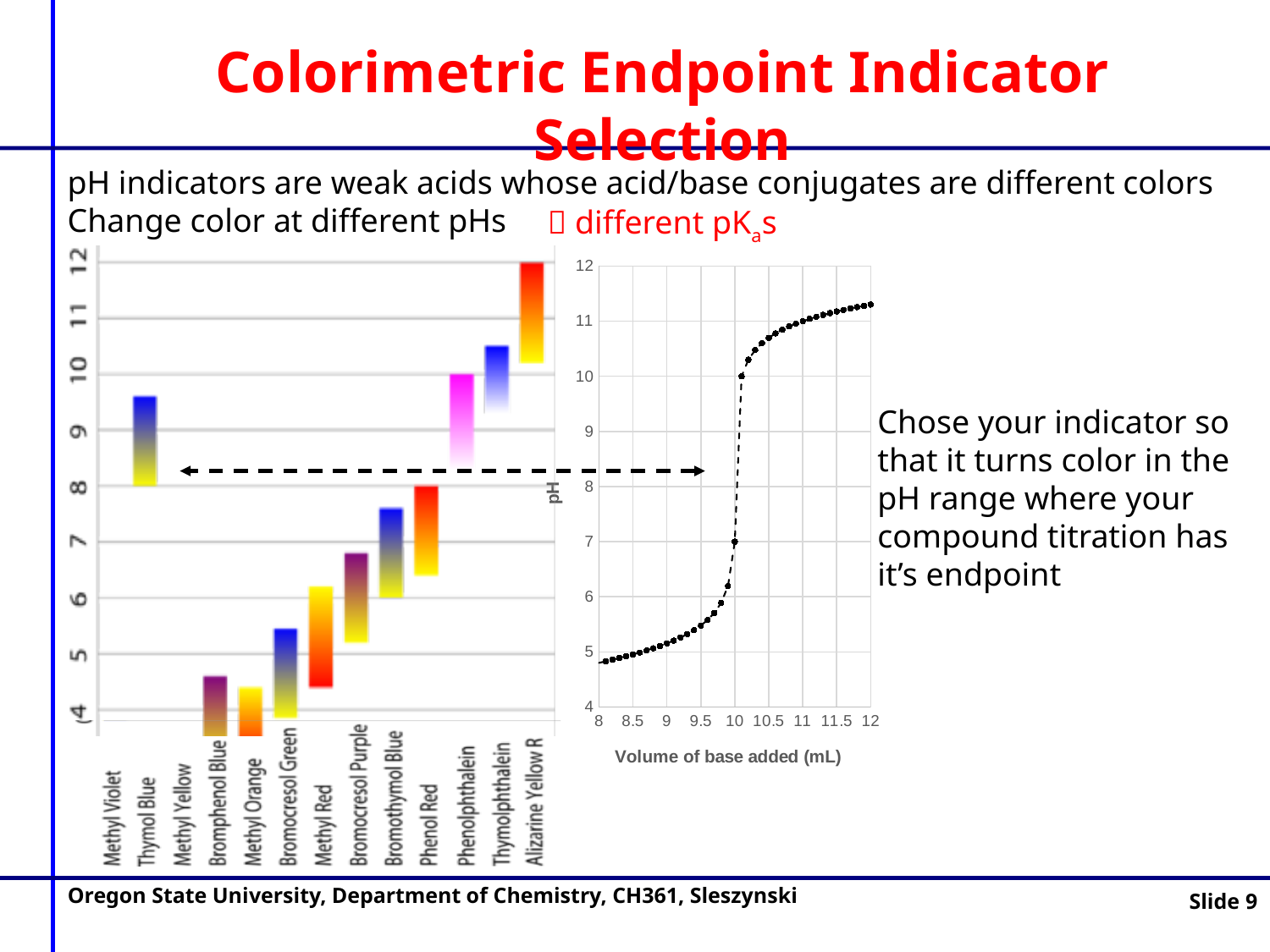
What kind of chart is the chart on the left showing indicator pH ranges? bar chart How many indicators are listed along the x axis of the chart on the left? 13 In the chart on the left, is the upper end of Phenolphthalein's range greater or less than 9? greater In the chart on the left, is the upper end of Thymol Blue's range greater or less than 9? greater In the chart on the right, does pH rise or fall as the volume of base added increases? rises In the chart on the right, is the pH at 12 mL of base added greater or less than 11? greater What is the x-axis label of the chart on the right? Volume of base added (mL) What kind of chart is the chart on the right of the slide (pH versus volume of base added)? line chart In the chart on the left, which indicator's range reaches a higher pH, Methyl Red or Bromothymol Blue? Bromothymol Blue In the chart on the left, which indicator's color-change range reaches the highest pH? Alizarine Yellow R